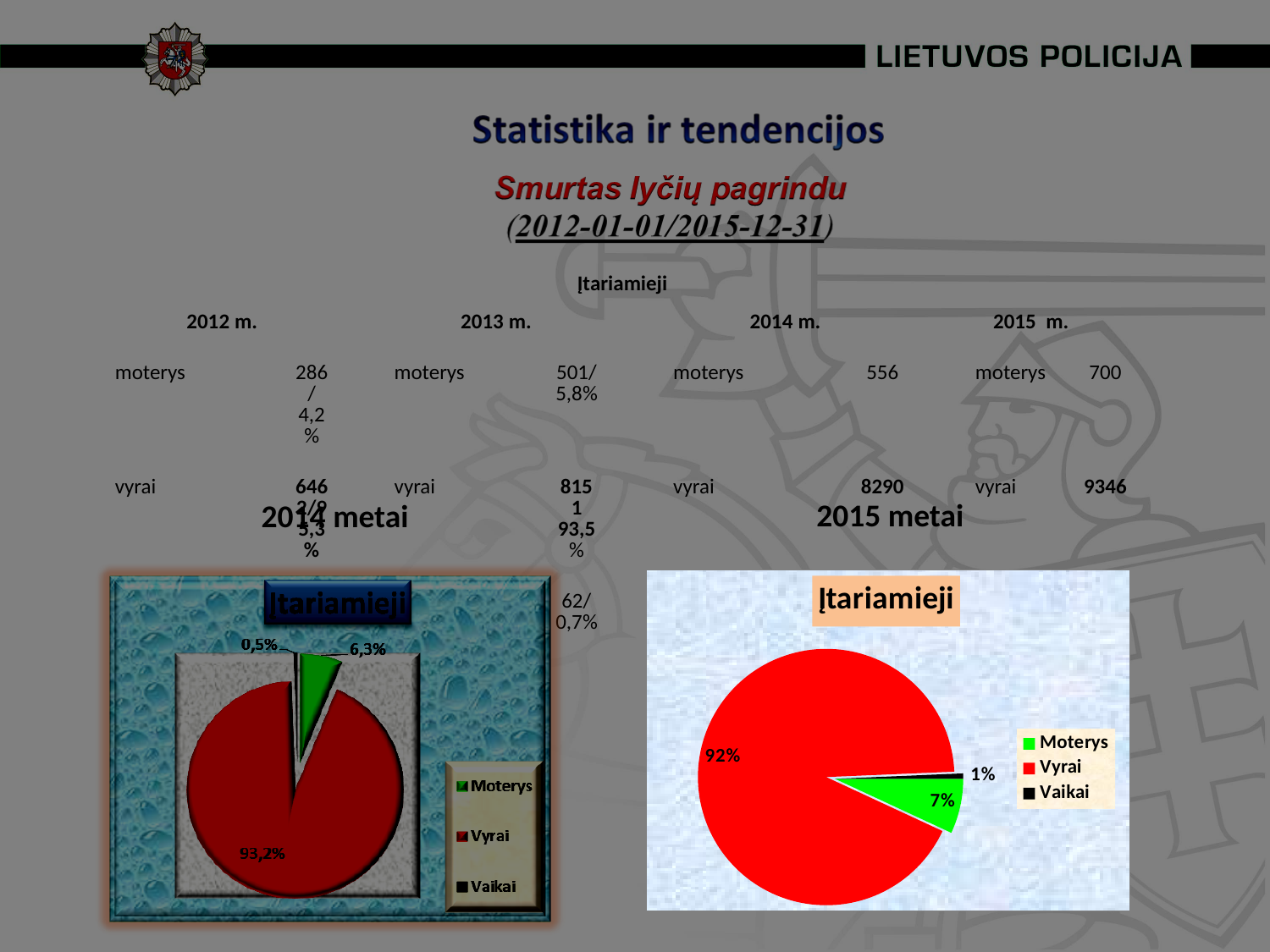
On the left pie chart (2014 metai), which category has the smallest slice? Vaikai On the left pie chart (2014 metai), what share is labelled for Vaikai? 0,5% On the left pie chart (2014 metai), what share is labelled for Vyrai? 93,2% On the right pie chart (2015 metai), what share is labelled for Vyrai? 92% On the right pie chart (2015 metai), what is the difference between the Moterys and Vaikai shares? 6% On the right pie chart (2015 metai), what share is labelled for Vaikai? 1% On the left pie chart (2014 metai), which is larger, the Moterys slice or the Vaikai slice? Moterys On the right pie chart (2015 metai), which category has the largest slice? Vyrai On the right pie chart (2015 metai), what share is labelled for Moterys? 7% What type of chart is shown on the left for 2014 metai? Pie chart On the left pie chart (2014 metai), what share is labelled for Moterys? 6,3% How many entries does the legend of the right pie chart (2015 metai) list? 3